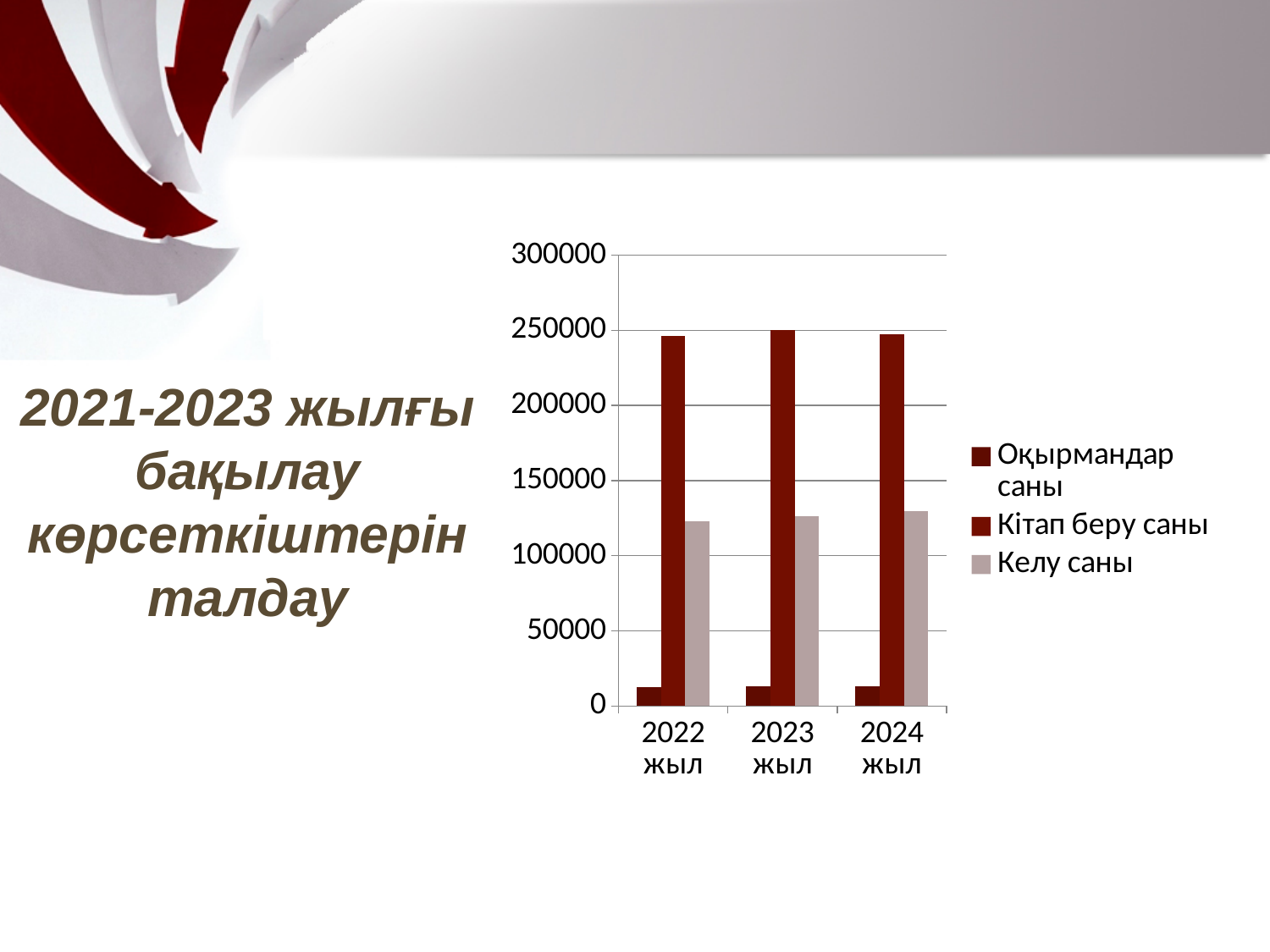
What kind of chart is shown on the slide? bar chart Is the value for Оқырмандар саны in 2023 жыл greater or less than 50000? less How many series does the chart's legend list? 3 Is the value for Кітап беру саны in 2023 жыл greater or less than 200000? greater Which series is lowest in 2024 жыл? Оқырмандар саны Is the value for Келу саны in 2022 жыл greater or less than 100000? greater Which series is highest in 2022 жыл? Кітап беру саны In 2023 жыл, which is larger: Кітап беру саны or Келу саны? Кітап беру саны What is the name of the third series listed in the chart's legend? Келу саны How many year categories are shown on the x axis of the chart? 3 Does Келу саны rise or fall from 2022 жыл to 2024 жыл? rise